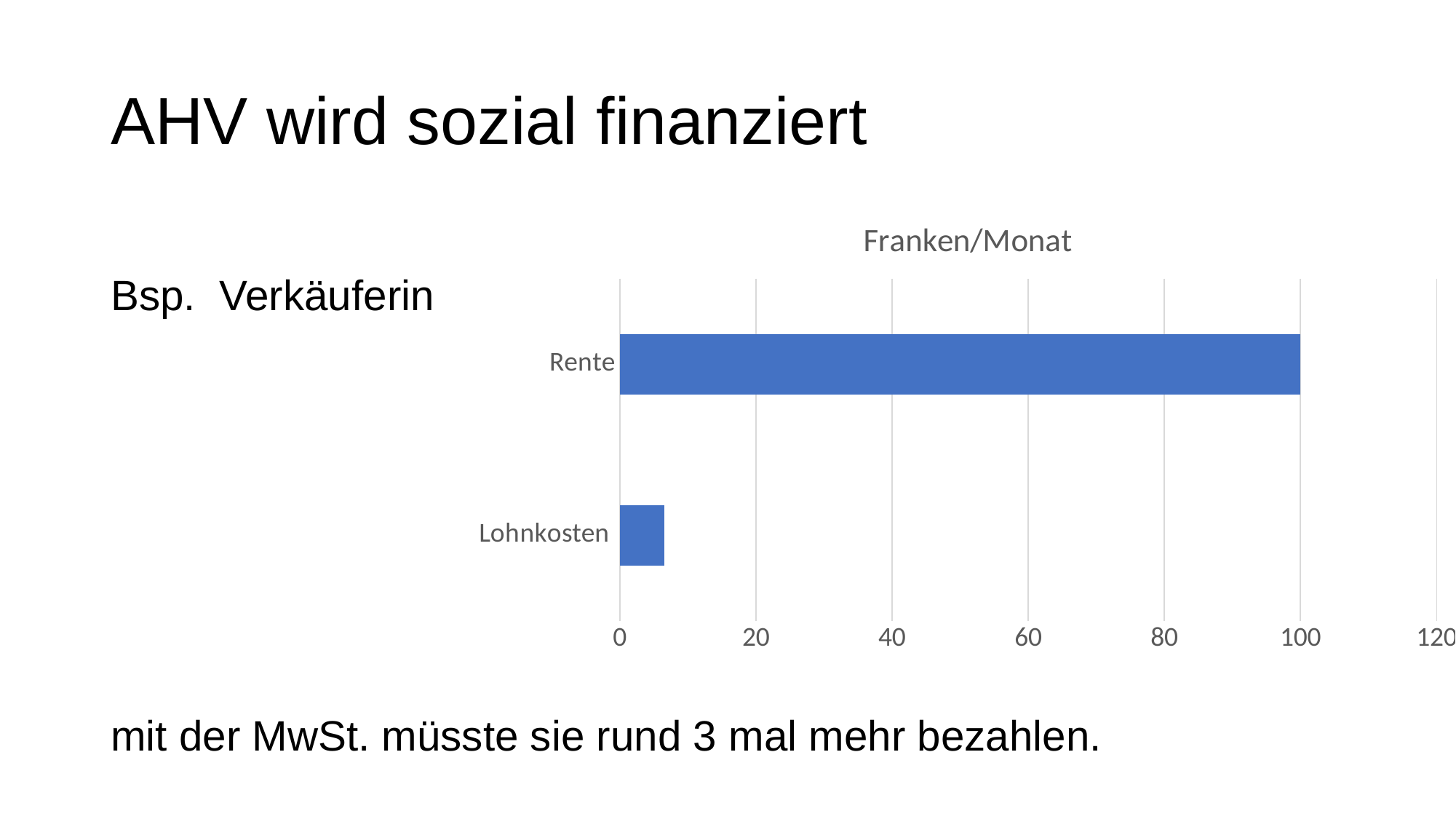
Is the value for Lohnkosten greater or less than 20? less What is the title of the chart? Franken/Monat What is the value for Rente in the chart? 100 What kind of chart is shown on the slide? bar chart Is the value for Rente greater or less than 120? less Which category has the lowest value in the chart? Lohnkosten What is the highest tick value shown on the x axis of the chart? 120 Is the value for Rente greater or less than 80? greater How many categories are plotted in the chart? 2 Which category has the highest value in the chart? Rente Which is larger, the value for Rente or the value for Lohnkosten? Rente